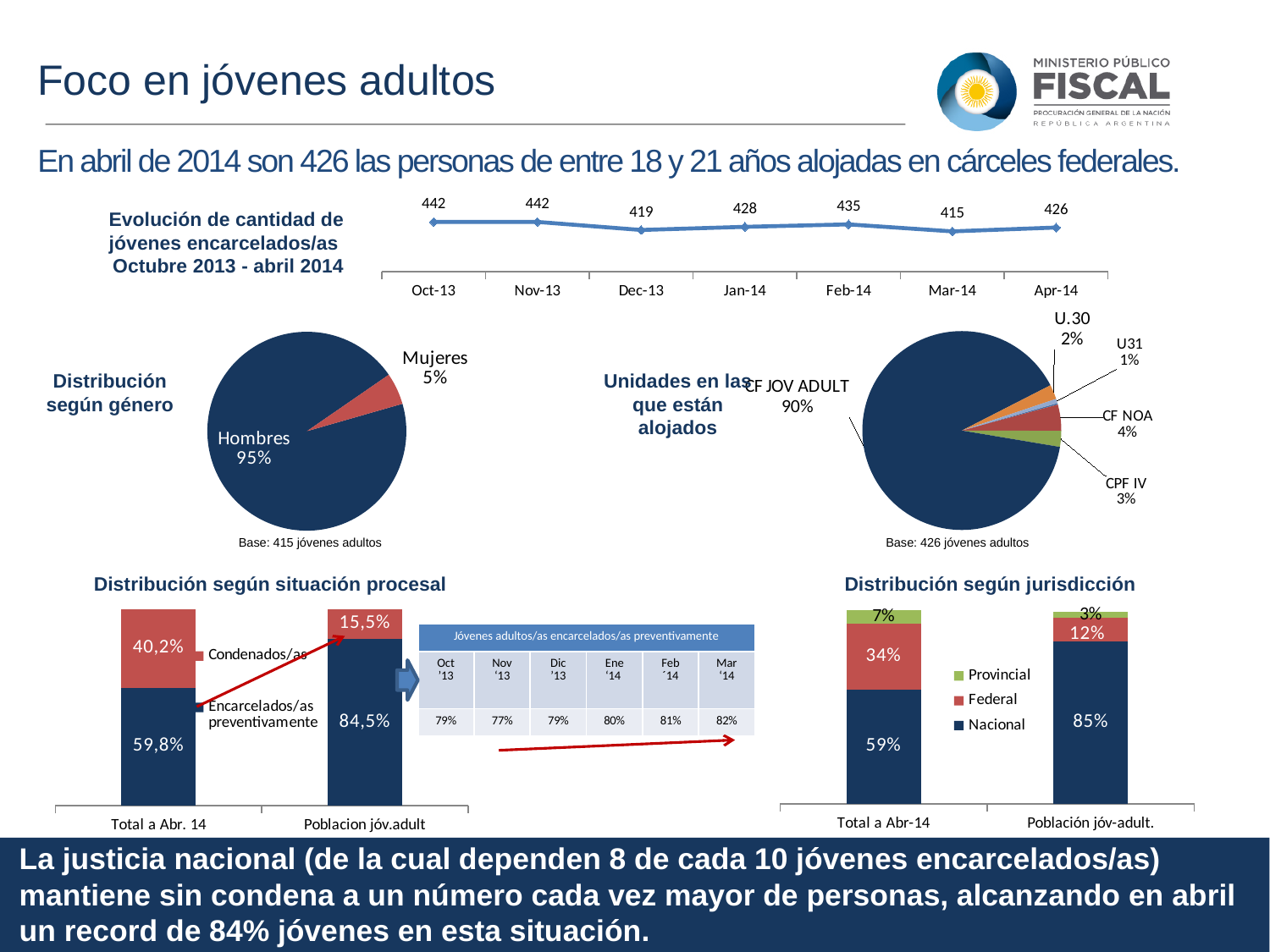
In the line chart 'Evolución de cantidad de jóvenes encarcelados/as', how many months are plotted? 7 In the bar chart 'Distribución según jurisdicción', what is the Federal value for Total a Abr-14? 34% In the line chart 'Evolución de cantidad de jóvenes encarcelados/as', what is the difference between the Oct-13 value and the Dec-13 value? 23 In the bar chart 'Distribución según situación procesal', what is the value for Encarcelados/as preventivamente in the Poblacion jóv.adult bar? 84,5% In the bar chart 'Distribución según jurisdicción', how many series does the legend list? 3 In the pie chart 'Unidades en las que están alojados', how many units are shown? 5 In the pie chart 'Unidades en las que están alojados', what share is CF NOA? 4% In the line chart 'Evolución de cantidad de jóvenes encarcelados/as', what is the value for Apr-14? 426 In the pie chart 'Distribución según género', what share is Mujeres? 5% In the pie chart 'Unidades en las que están alojados', which unit has the smallest share? U31 In the line chart 'Evolución de cantidad de jóvenes encarcelados/as', which month has the lowest value? Mar-14 In the line chart 'Evolución de cantidad de jóvenes encarcelados/as', is the value for Feb-14 larger or smaller than the value for Mar-14? larger